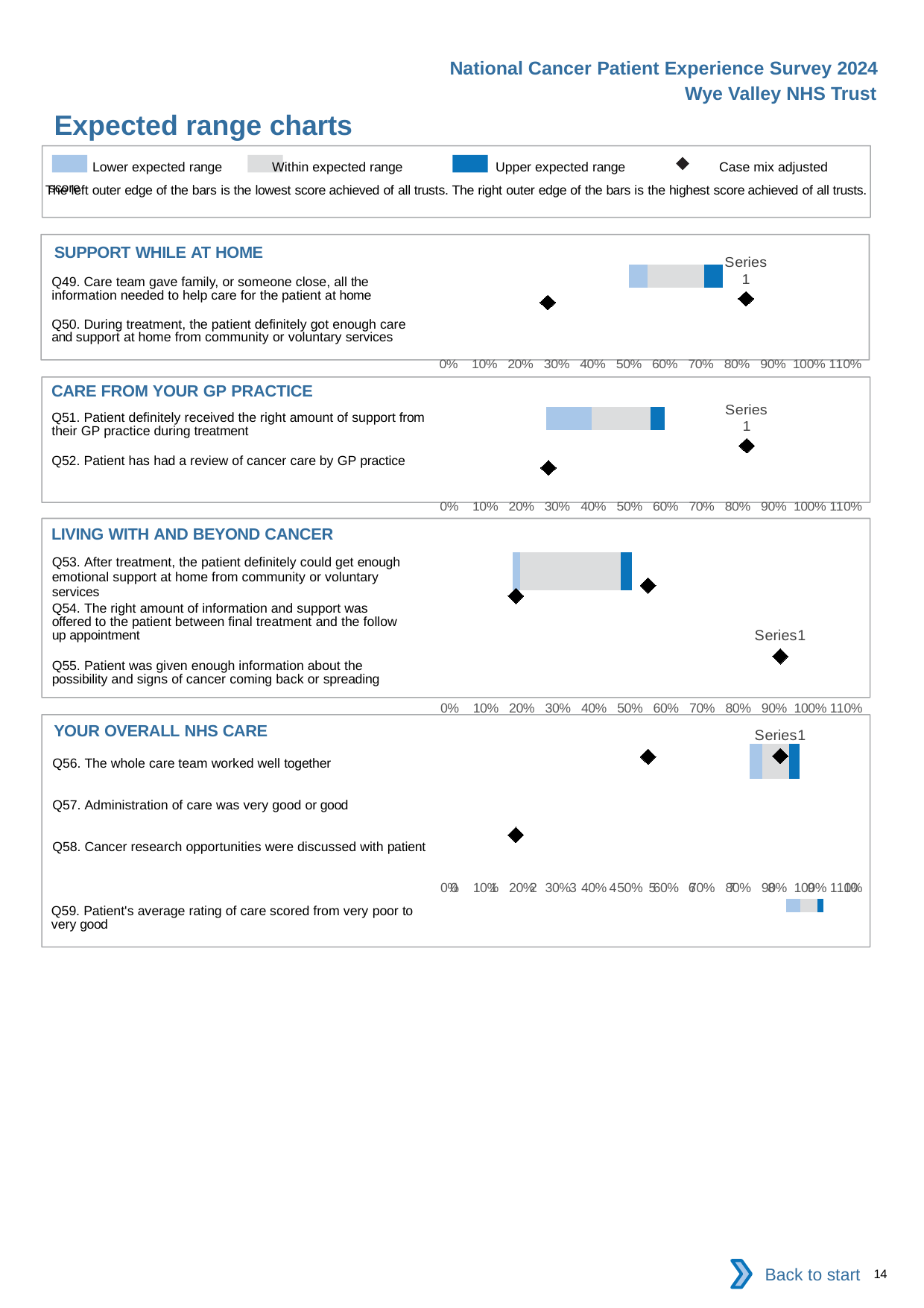
What does the black diamond marker represent according to the legend? Case mix adjusted score How many entries does the legend at the top of the slide list? 4 In the SUPPORT WHILE AT HOME chart, is the right edge of the expected range bar greater or less than 70%? greater How many questions are listed in the SUPPORT WHILE AT HOME chart? 2 How many questions are listed in the CARE FROM YOUR GP PRACTICE chart? 2 How many questions are listed in the LIVING WITH AND BEYOND CANCER chart? 3 What does the dark blue colour represent according to the legend? Upper expected range What is the highest value shown on the x axis of the CARE FROM YOUR GP PRACTICE chart? 110% What kind of chart is used in the SUPPORT WHILE AT HOME section? bar chart In the CARE FROM YOUR GP PRACTICE chart, is the right edge of the expected range bar greater or less than 70%? less